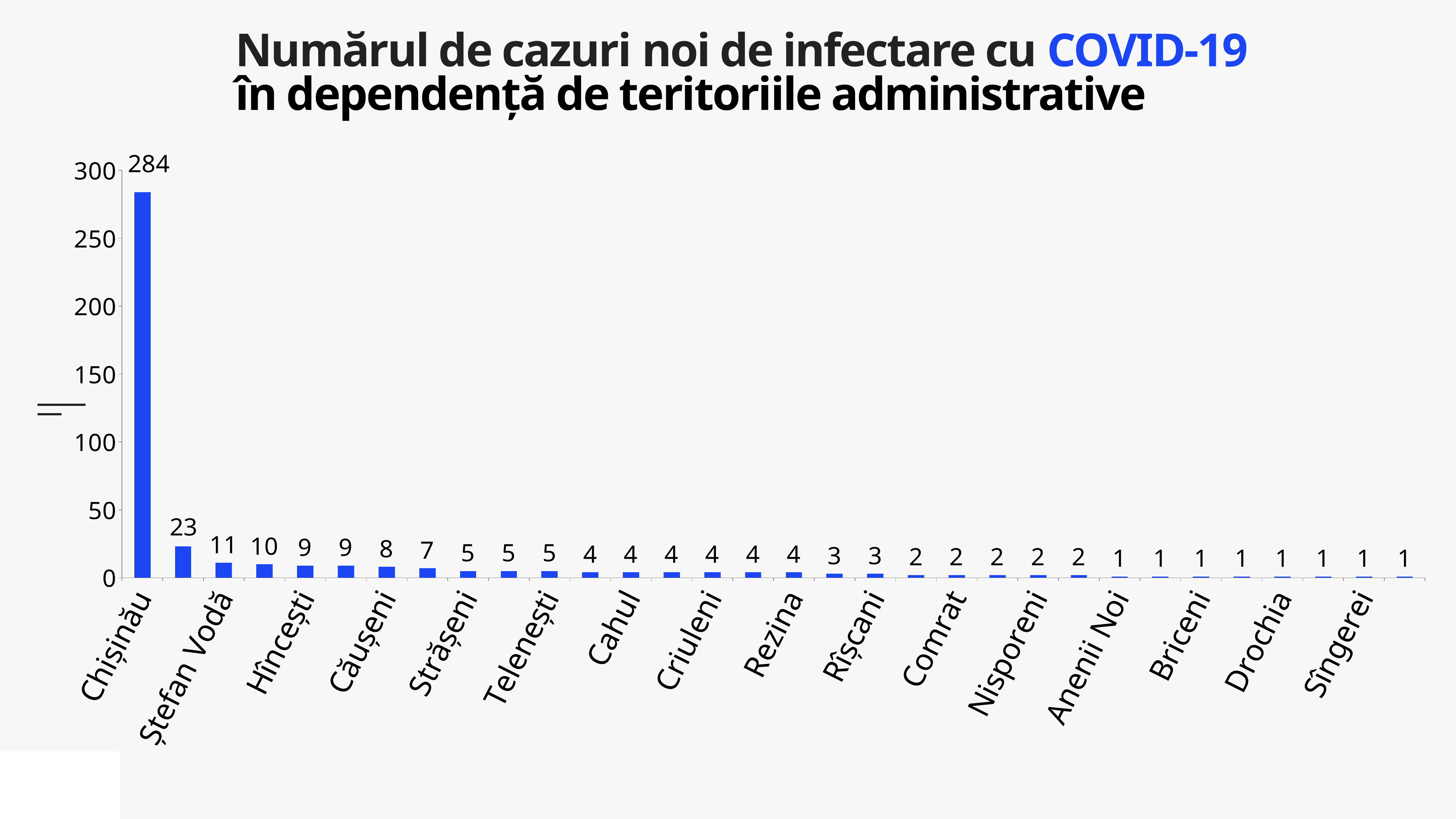
What is the value for Comrat? 2 Which territory has the highest number of new cases? Chișinău What is the value for Chișinău? 284 Which is larger, the value for Chișinău or the value for Criuleni? Chișinău Is the value for Chișinău greater or less than 250? greater What is the value for Sîngerei? 1 Do the values rise or fall from left to right along the x axis? fall How many bars are plotted in the chart? 32 What kind of chart is shown on the slide? bar chart What is the difference between the values for Chișinău and Rezina? 280 What is the value for Cahul? 4 What is the value for Rîșcani? 3